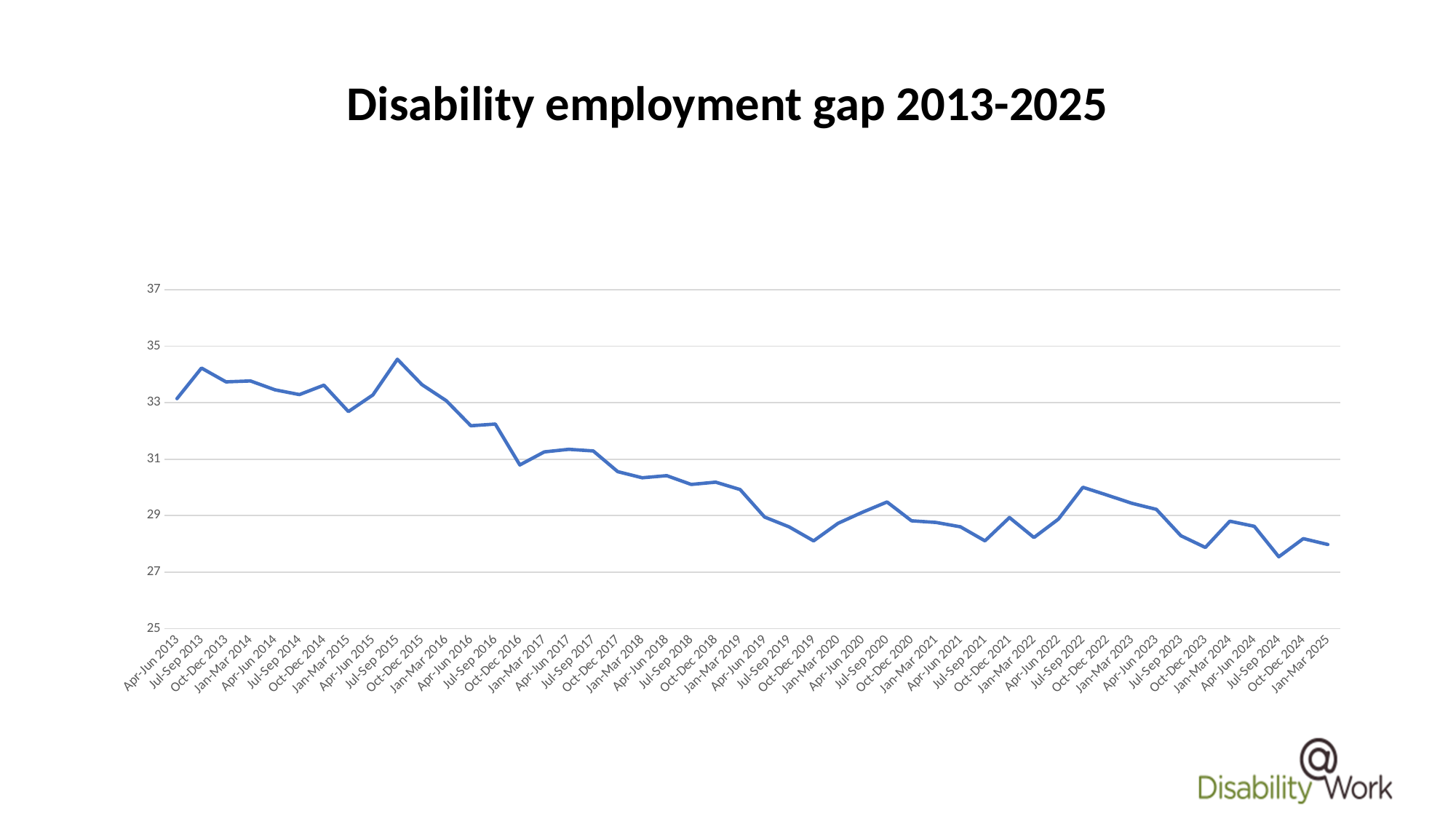
Is the value for Jul-Sep 2015 greater or less than 33? greater Is the value for Jan-Mar 2025 greater or less than 29? less Which is larger, the value for Apr-Jun 2013 or the value for Jan-Mar 2025? Apr-Jun 2013 Overall, do the values rise or fall from Apr-Jun 2013 to Jan-Mar 2025? fall What is the first quarter shown on the x axis? Apr-Jun 2013 Is the value for Oct-Dec 2019 greater or less than 29? less What is the title of the chart? Disability employment gap 2013-2025 What kind of chart is shown on the slide? line chart Which quarter has the lowest value on the chart? Jul-Sep 2024 How many quarterly data points are plotted on the chart? 48